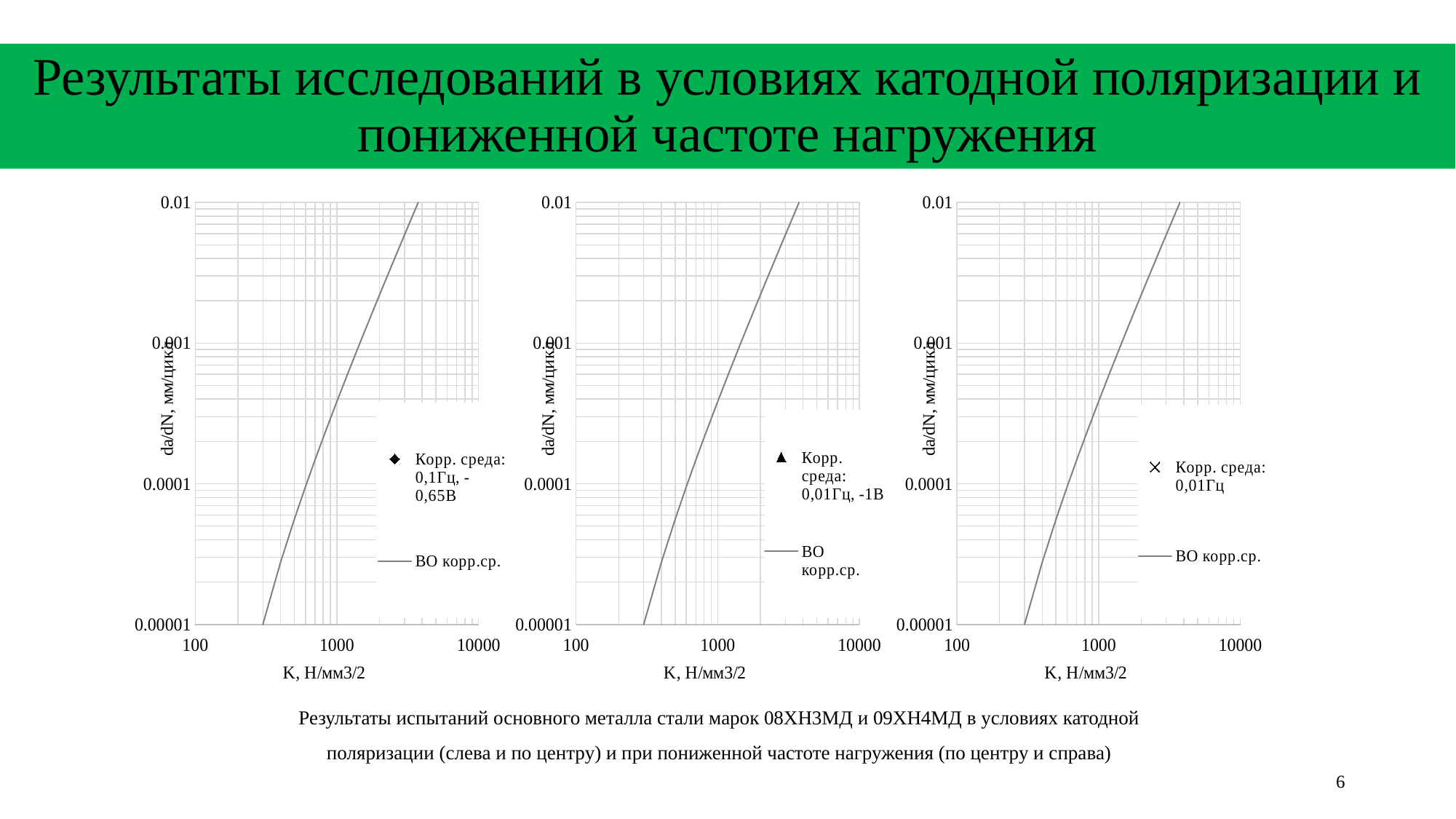
In the middle chart, is the value of da/dN at K = 1000 greater or less than 0.0001? greater What is the name of the line series in the legend of the right chart? ВО корр.ср. What kind of chart is the left chart on the slide? line chart In the left chart, is the value of da/dN at K = 1000 greater or less than 0.001? less How many charts are shown on the slide? 3 In the left chart, does the plotted line rise or fall as K increases along the x axis? rises How many series does the legend of the right chart list? 2 What is the lowest value shown on the x axis of the right chart? 100 What is the highest value shown on the y axis of the left chart? 0.01 How many series does the legend of the left chart list? 2 What is the x-axis label of the middle chart? K, Н/мм3/2 In the right chart, does the plotted line rise or fall as K increases along the x axis? rises